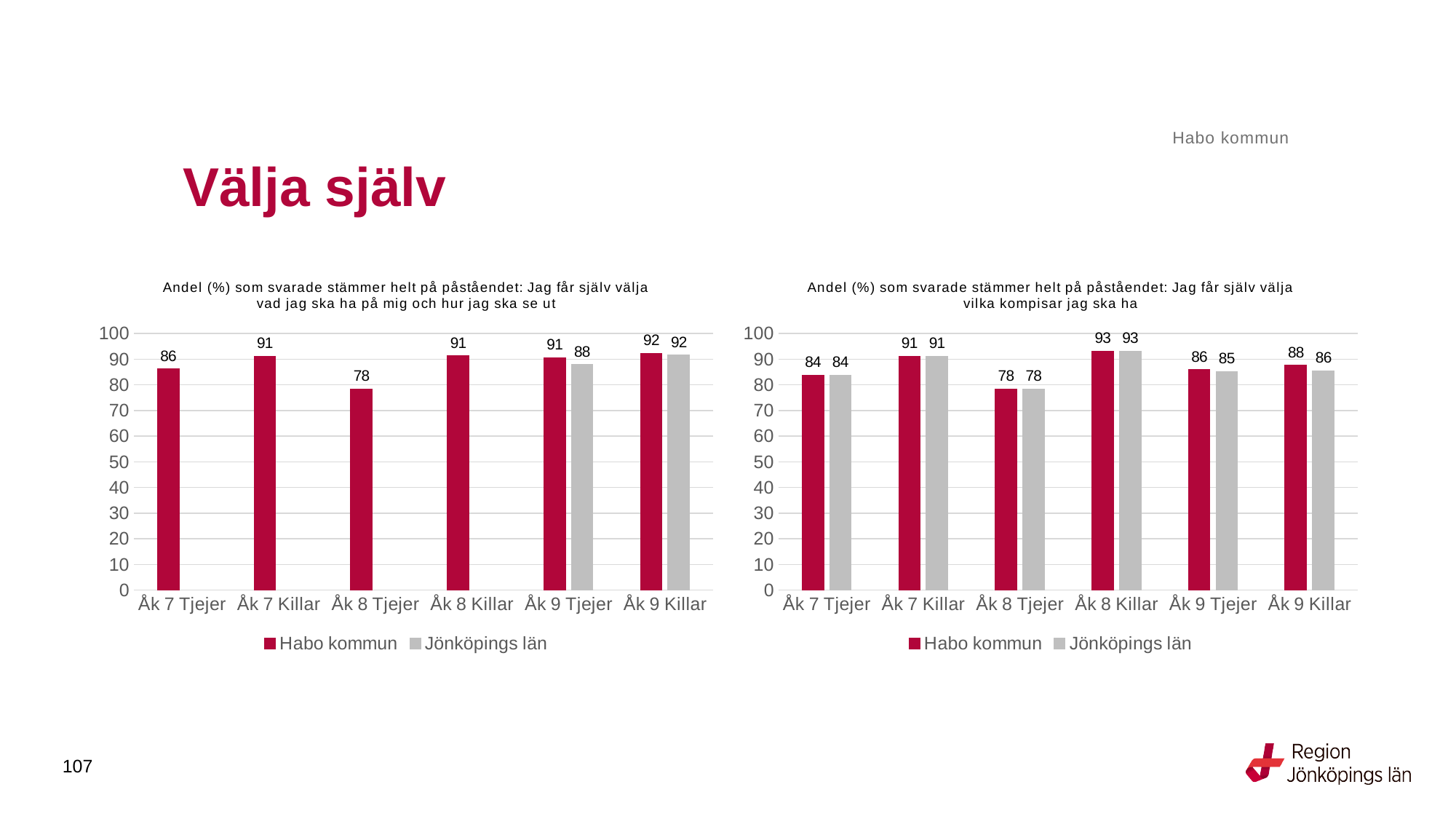
In the right chart, which category has the lowest value for Jönköpings län? Åk 8 Tjejer In the left chart, what is the value for Habo kommun for Åk 8 Tjejer? 78 In the right chart, what is the value for Jönköpings län for Åk 9 Killar? 86 In the left chart, what is the value for Jönköpings län for Åk 9 Tjejer? 88 What type of chart is the right chart? Bar chart In the left chart, which category has the lowest value for Habo kommun? Åk 8 Tjejer In the right chart, how many categories are shown on the x axis? 6 In the right chart, what is the value for Habo kommun for Åk 8 Killar? 93 In the left chart, which category has the highest value for Habo kommun? Åk 9 Killar In the left chart, what is the difference between Habo kommun and Jönköpings län for Åk 9 Tjejer? 3 In the right chart, what is the difference between Habo kommun and Jönköpings län for Åk 9 Killar? 2 How many series does the legend of the left chart list? 2